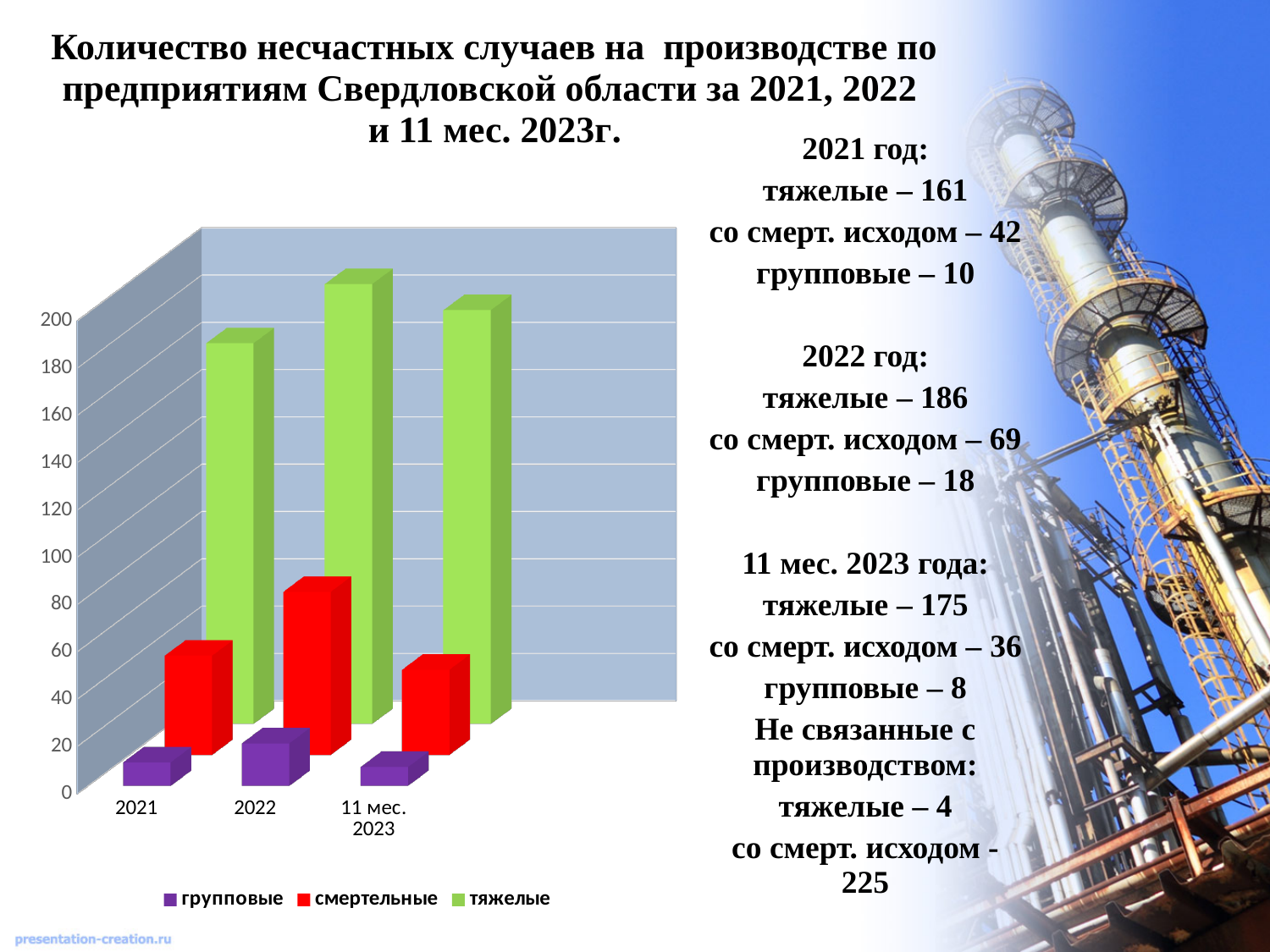
How many series does the chart legend list? 3 According to the slide, what is the number of тяжелые cases in 2022? 186 Is the value for тяжелые in 2021 greater or less than 100? greater How many categories are shown on the x axis of the chart? 3 Does the смертельные value rise or fall from 2021 to 2022? rise Is the value for смертельные in 2022 greater or less than 100? less In which category is the смертельные bar the tallest? 2022 In which year is the тяжелые bar the tallest? 2022 Which series is shown in green in the chart legend? тяжелые Which is larger: the смертельные value for 2022 or for 11 мес. 2023? 2022 What kind of chart is shown on the slide? bar chart In which category is the групповые bar the tallest? 2022